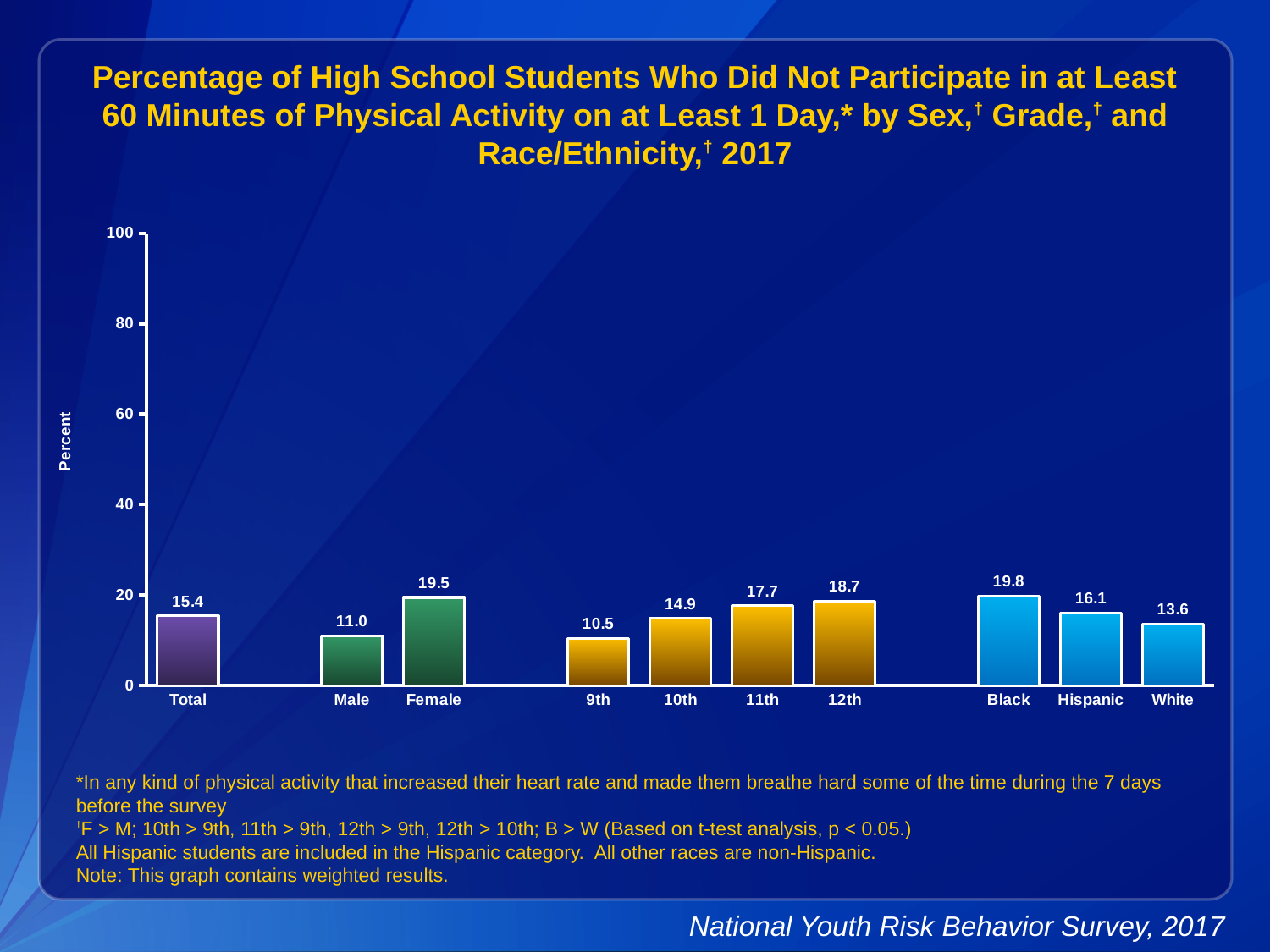
What is the difference between the Female and Male values? 8.5 Which category has the highest value? Black Is the value for 12th grade greater or less than 20? less What kind of chart is this? bar chart What is the value for Total? 15.4 What is the value for 9th grade? 10.5 Which category has the lowest value? 9th Which is larger, the value for Black or the value for White? Black What is the value for Hispanic students? 16.1 How many categories are shown on the x axis? 10 What is the value for Female? 19.5 Do the values rise or fall from 9th grade to 12th grade? rise